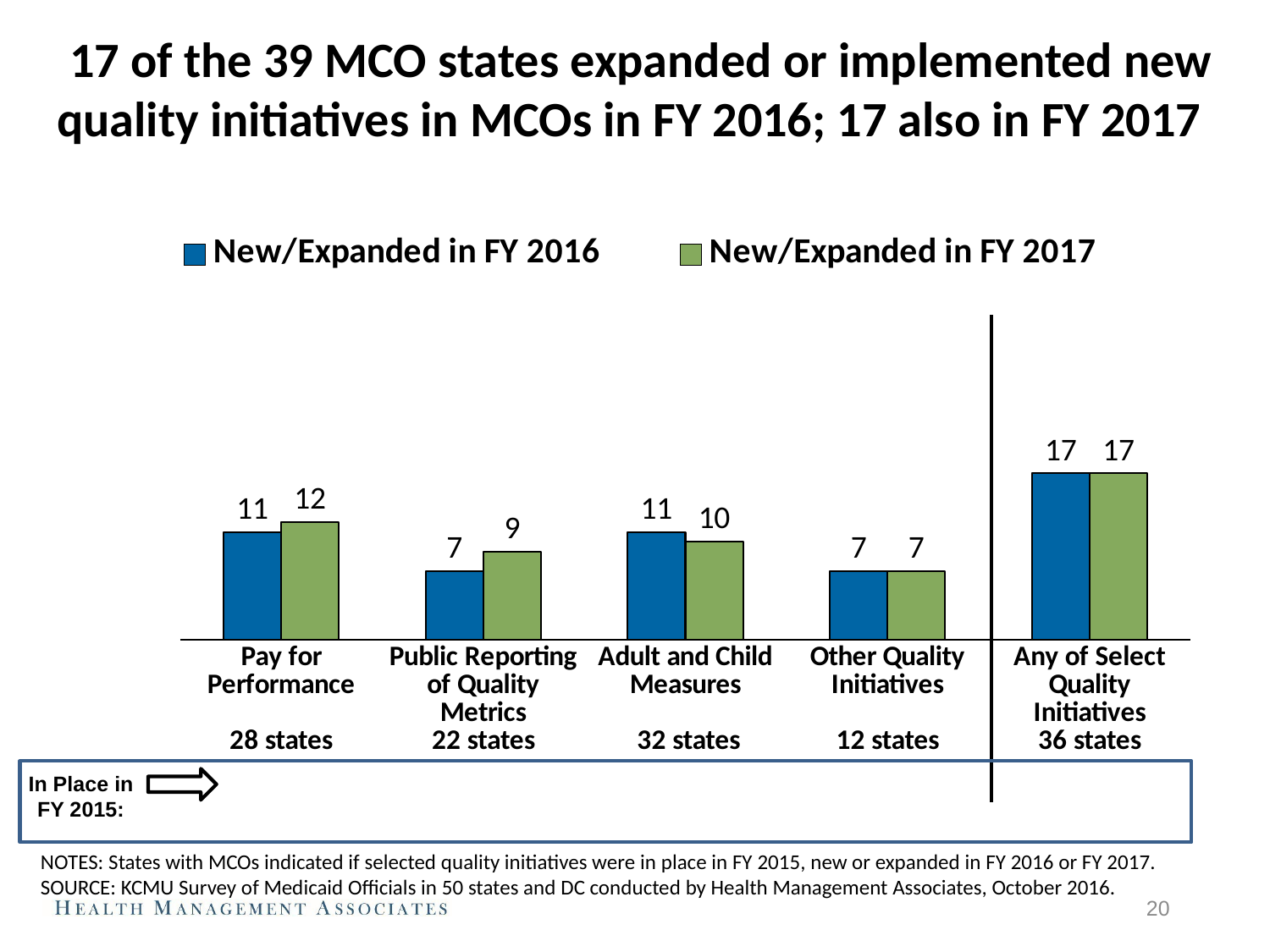
What is the value for Adult and Child Measures in the New/Expanded in FY 2017 series? 10 What is the difference between the FY 2017 and FY 2016 values for Public Reporting of Quality Metrics? 2 Which category has the highest value in the New/Expanded in FY 2017 series? Any of Select Quality Initiatives What kind of chart is shown on the slide? Bar chart How many series does the legend list? 2 How many categories are shown on the x axis of the chart? 5 What is the value for Any of Select Quality Initiatives in the New/Expanded in FY 2016 series? 17 What is the value for Pay for Performance in the New/Expanded in FY 2016 series? 11 For Adult and Child Measures, which series has the larger value, New/Expanded in FY 2016 or New/Expanded in FY 2017? New/Expanded in FY 2016 According to the label below the chart, how many states had Other Quality Initiatives in place in FY 2015? 12 states What is the value for Public Reporting of Quality Metrics in the New/Expanded in FY 2017 series? 9 Which category has the lowest value in the New/Expanded in FY 2016 series? Public Reporting of Quality Metrics and Other Quality Initiatives (tied at 7)